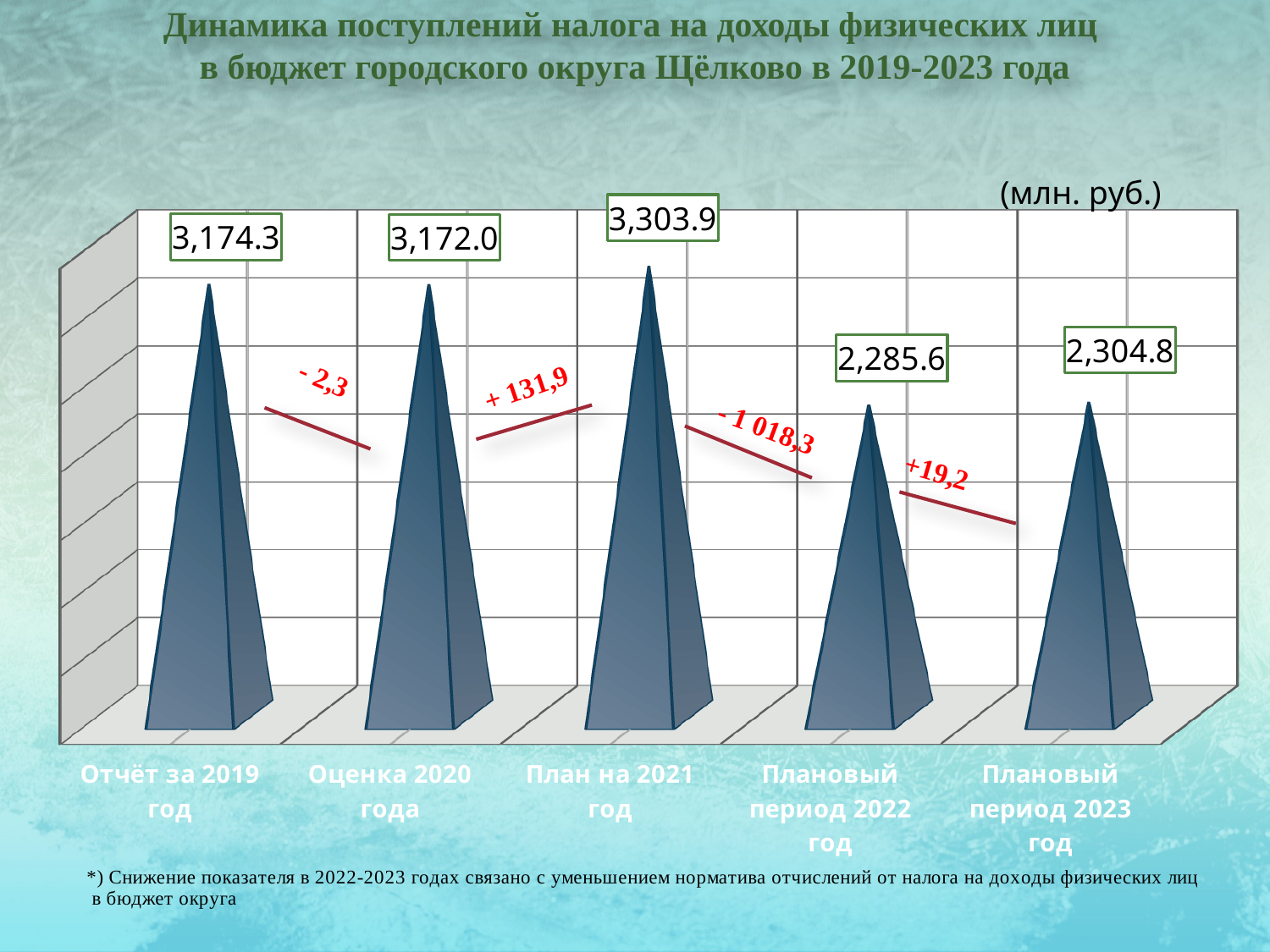
What is the value for «Отчёт за 2019 год»? 3,174.3 How many categories are shown on the chart? 5 Which category has the lowest value? Плановый период 2022 год Which is larger: the value for «Отчёт за 2019 год» or for «Оценка 2020 года»? Отчёт за 2019 год What kind of chart is shown on the slide? Bar chart What is the difference between the values for «План на 2021 год» and «Плановый период 2022 год»? 1,018.3 Does the value rise or fall from «План на 2021 год» to «Плановый период 2022 год»? Fall In what units are the chart values given? млн. руб. What is the value for «Плановый период 2023 год»? 2,304.8 What is the value for «План на 2021 год»? 3,303.9 Which category has the highest value? План на 2021 год What is the difference between the values for «План на 2021 год» and «Оценка 2020 года»? 131.9